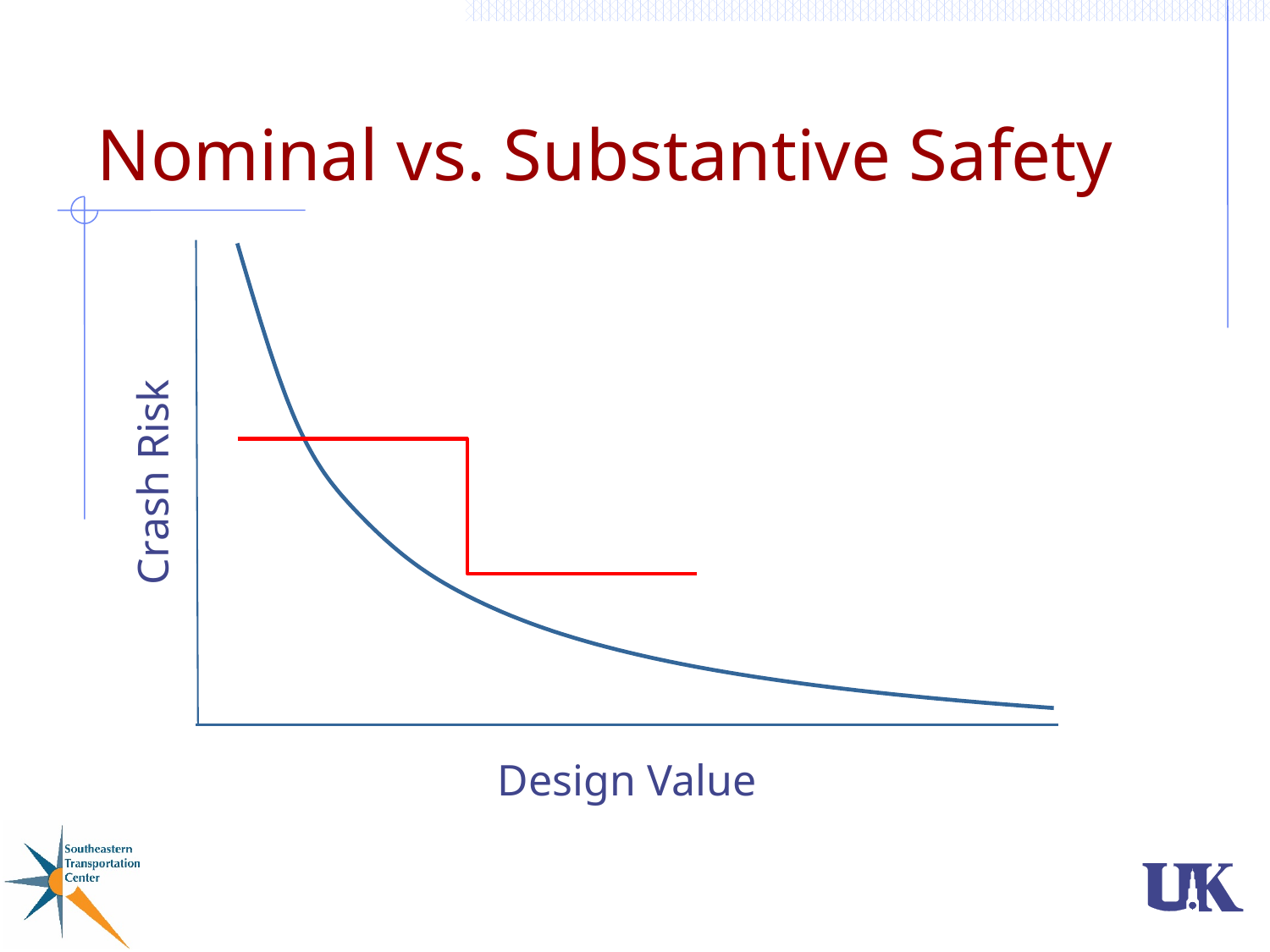
Does the blue curve rise or fall as Design Value increases? fall What kind of chart is shown on the slide? line chart What is the title of the slide containing the chart? Nominal vs. Substantive Safety Does the red stepped line rise or fall as Design Value increases? fall How many lines are plotted on the chart? 2 What is the label on the vertical axis of the chart? Crash Risk